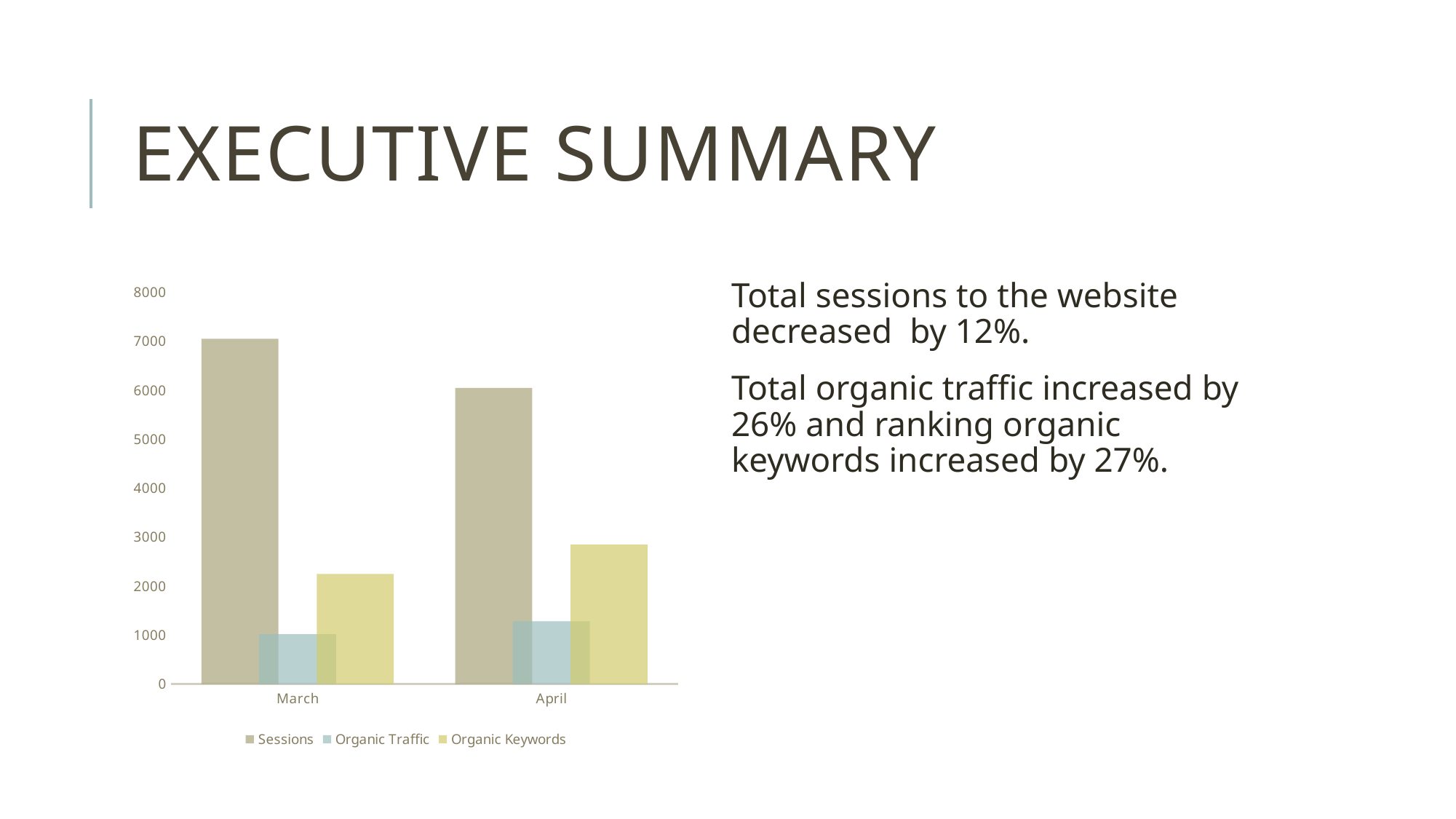
What kind of chart is shown on the slide? bar chart Which series has the tallest bar in the chart? Sessions Which month has the larger Organic Keywords value, March or April? April Is the Sessions value for April greater or less than 7000? less Is the Organic Keywords value for April greater or less than 3000? less Which series has the shortest bar in the chart? Organic Traffic Do the Sessions values rise or fall from March to April? fall Is the Sessions value for March greater or less than 6000? greater Which month has the larger Sessions value, March or April? March How many months are shown on the x axis of the chart? 2 How many series does the chart's legend list? 3